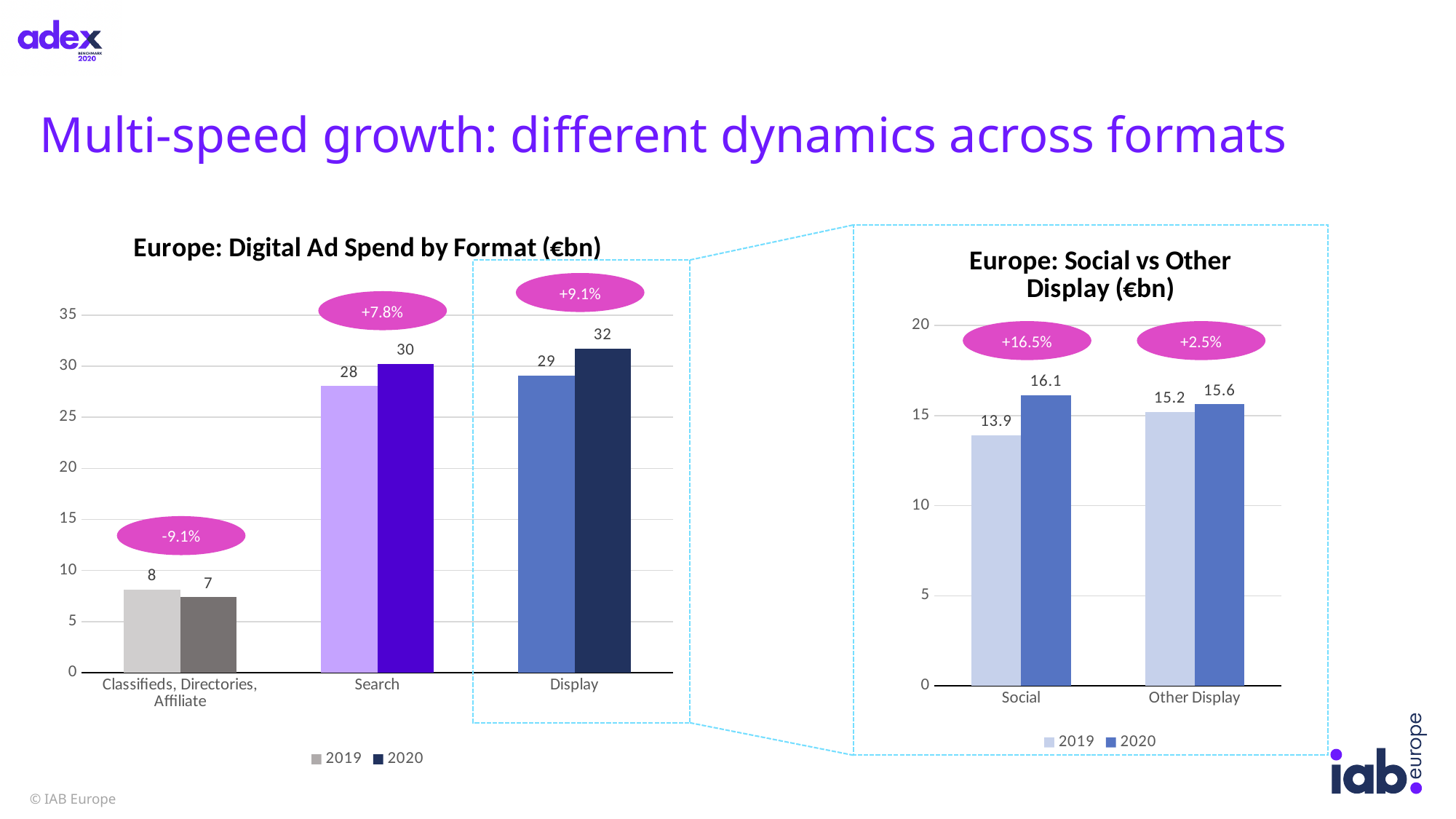
In the 'Europe: Digital Ad Spend by Format (€bn)' chart, what is the 2019 value for Display? 29 In the 'Europe: Social vs Other Display (€bn)' chart, what is the 2020 value for Social? 16.1 What type of chart is 'Europe: Social vs Other Display (€bn)'? bar chart In the 'Europe: Digital Ad Spend by Format (€bn)' chart, which format has the highest 2020 value? Display In the 'Europe: Digital Ad Spend by Format (€bn)' chart, what is the difference between the 2020 and 2019 values for Display? 3 In the 'Europe: Digital Ad Spend by Format (€bn)' chart, which format has the lowest 2019 value? Classifieds, Directories, Affiliate In the 'Europe: Social vs Other Display (€bn)' chart, what is the difference between the 2020 and 2019 values for Other Display? 0.4 In the 'Europe: Digital Ad Spend by Format (€bn)' chart, is the 2019 value for Classifieds, Directories, Affiliate larger or smaller than its 2020 value? larger How many formats are shown on the x axis of the 'Europe: Digital Ad Spend by Format (€bn)' chart? 3 In the 'Europe: Social vs Other Display (€bn)' chart, what growth percentage is shown above the Social bars? +16.5% In the 'Europe: Digital Ad Spend by Format (€bn)' chart, what is the 2020 value for Search? 30 How many series does the legend of the 'Europe: Social vs Other Display (€bn)' chart list? 2